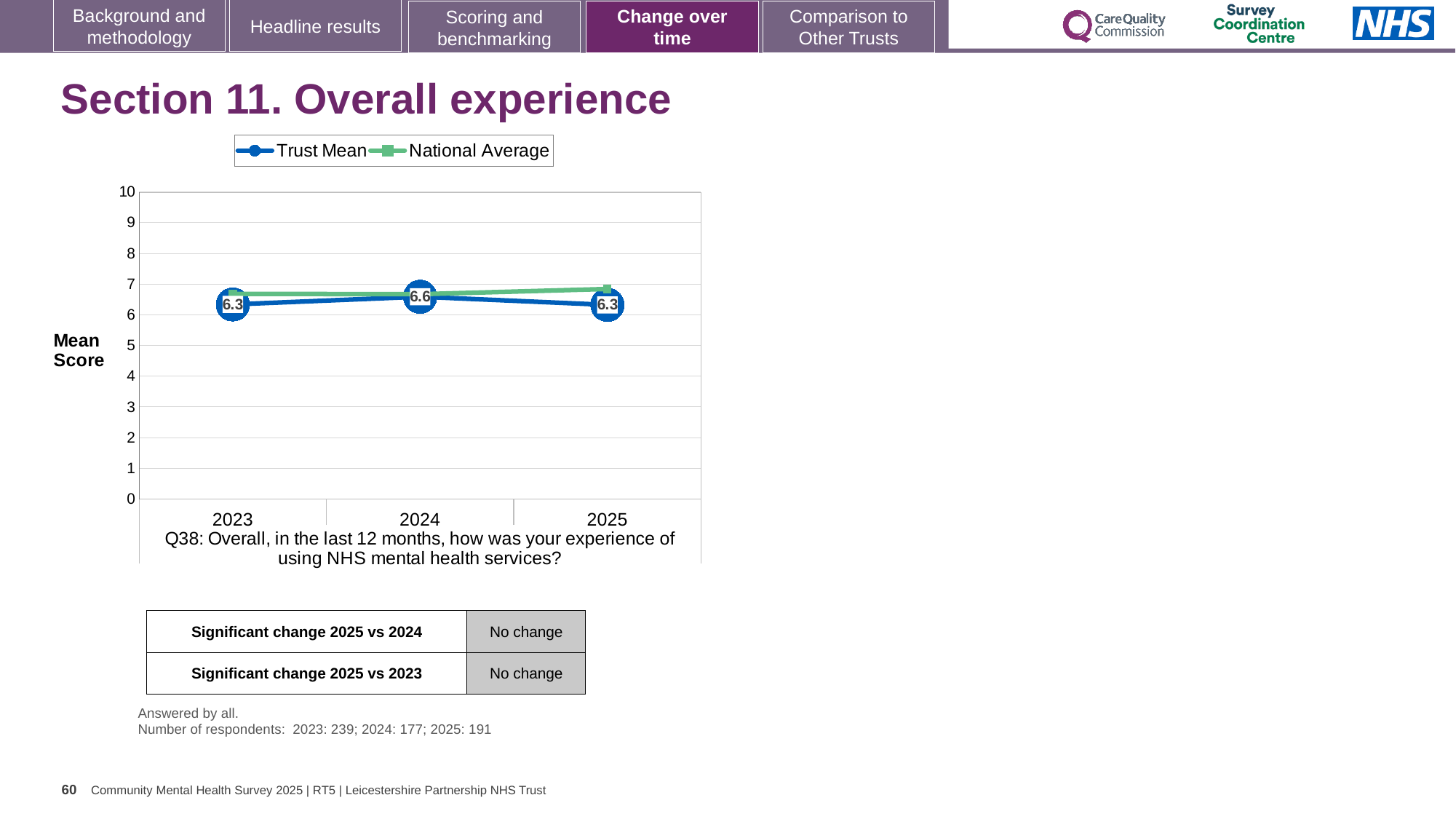
Does the Trust Mean rise or fall from 2024 to 2025? Fall In which year is the Trust Mean highest? 2024 What is the Trust Mean value for 2023? 6.3 What is the Trust Mean value for 2025? 6.3 What kind of chart is shown on the slide? Line chart Which is larger, the Trust Mean in 2024 or the Trust Mean in 2025? 2024 How many series does the legend list? 2 What label is shown on the y axis of the chart? Mean Score What is the difference between the Trust Mean in 2024 and in 2023? 0.3 What is the Trust Mean value for 2024? 6.6 How many years are plotted on the x axis? 3 Is the National Average value for 2025 greater or less than 6? greater